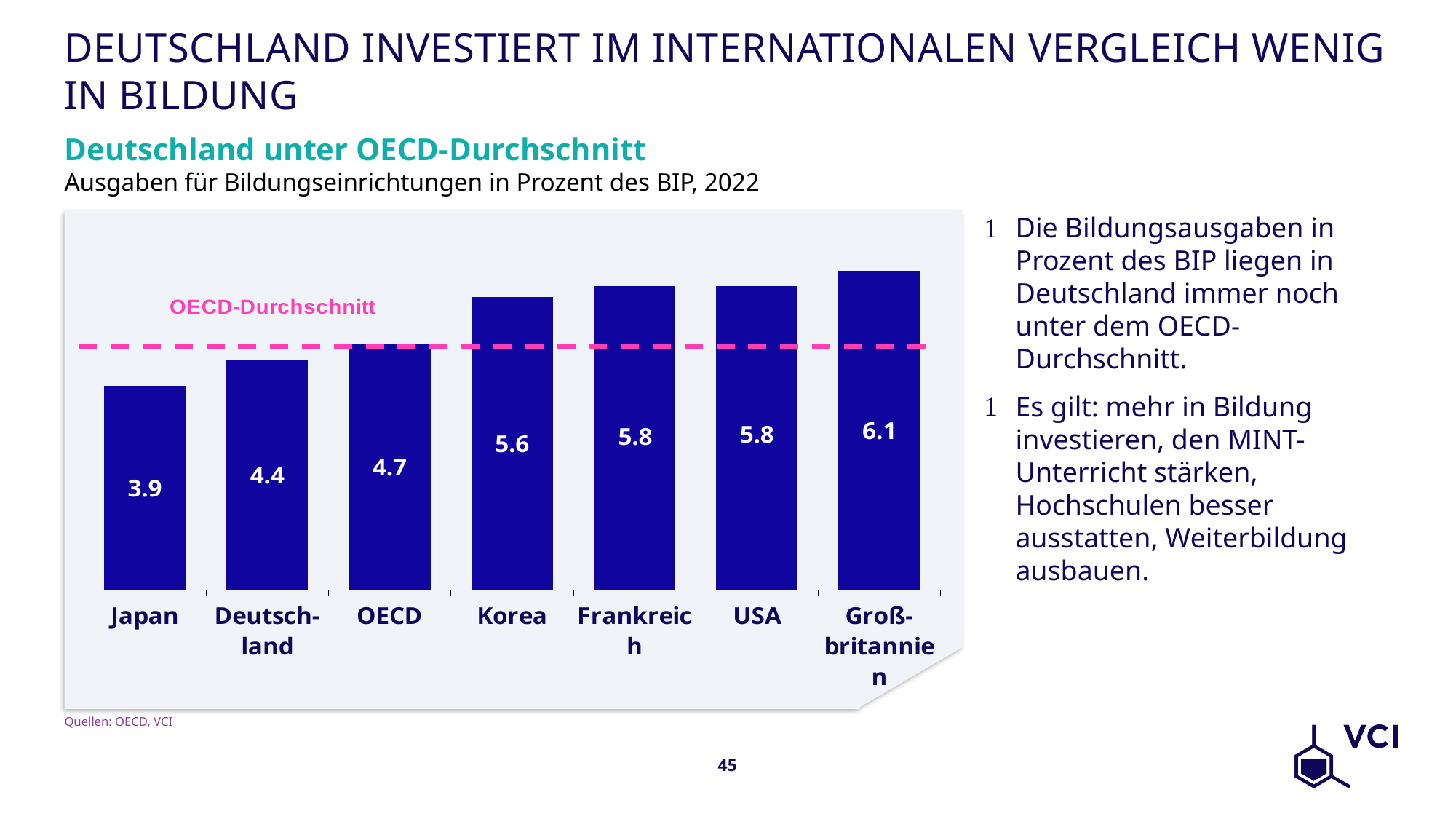
Which category has the highest value? Großbritannien Which is larger, the value for Korea or the value for Deutschland? Korea What does the pink dashed line in the chart represent? OECD-Durchschnitt What is the value for Japan? 3.9 What is the value for Deutschland? 4.4 How many bars are shown in the chart? 7 What is the difference between the values for Großbritannien and Japan? 2.2 What kind of chart is shown on the slide? Bar chart What is the value for Korea? 5.6 Which category has the lowest value? Japan What is the value for Großbritannien? 6.1 What is the difference between the OECD value and the value for Deutschland? 0.3